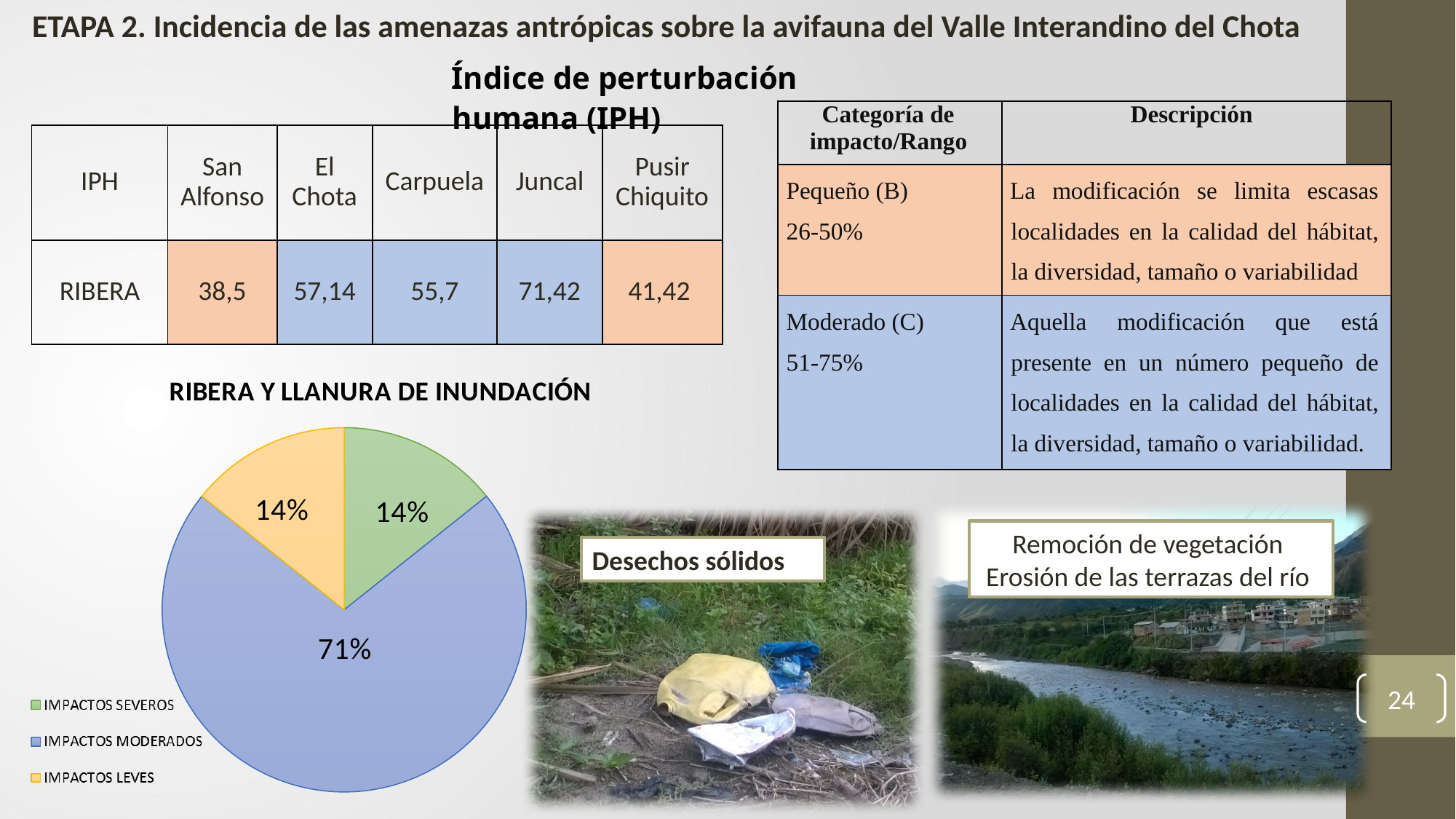
In the pie chart, what share is labelled for IMPACTOS LEVES? 14% In the pie chart, what colour is the slice for IMPACTOS LEVES? yellow What is the title of the pie chart on the slide? RIBERA Y LLANURA DE INUNDACIÓN In the pie chart, what share is labelled for IMPACTOS SEVEROS? 14% Which category has the largest slice in the pie chart? IMPACTOS MODERADOS How many slices does the pie chart have? 3 What type of chart is shown under the title "RIBERA Y LLANURA DE INUNDACIÓN"? pie chart In the pie chart, what share is labelled for IMPACTOS MODERADOS? 71% How many entries does the legend of the pie chart list? 3 In the pie chart, which is larger: IMPACTOS MODERADOS or IMPACTOS LEVES? IMPACTOS MODERADOS In the pie chart, what is the difference between the share for IMPACTOS MODERADOS and the share for IMPACTOS SEVEROS? 57%